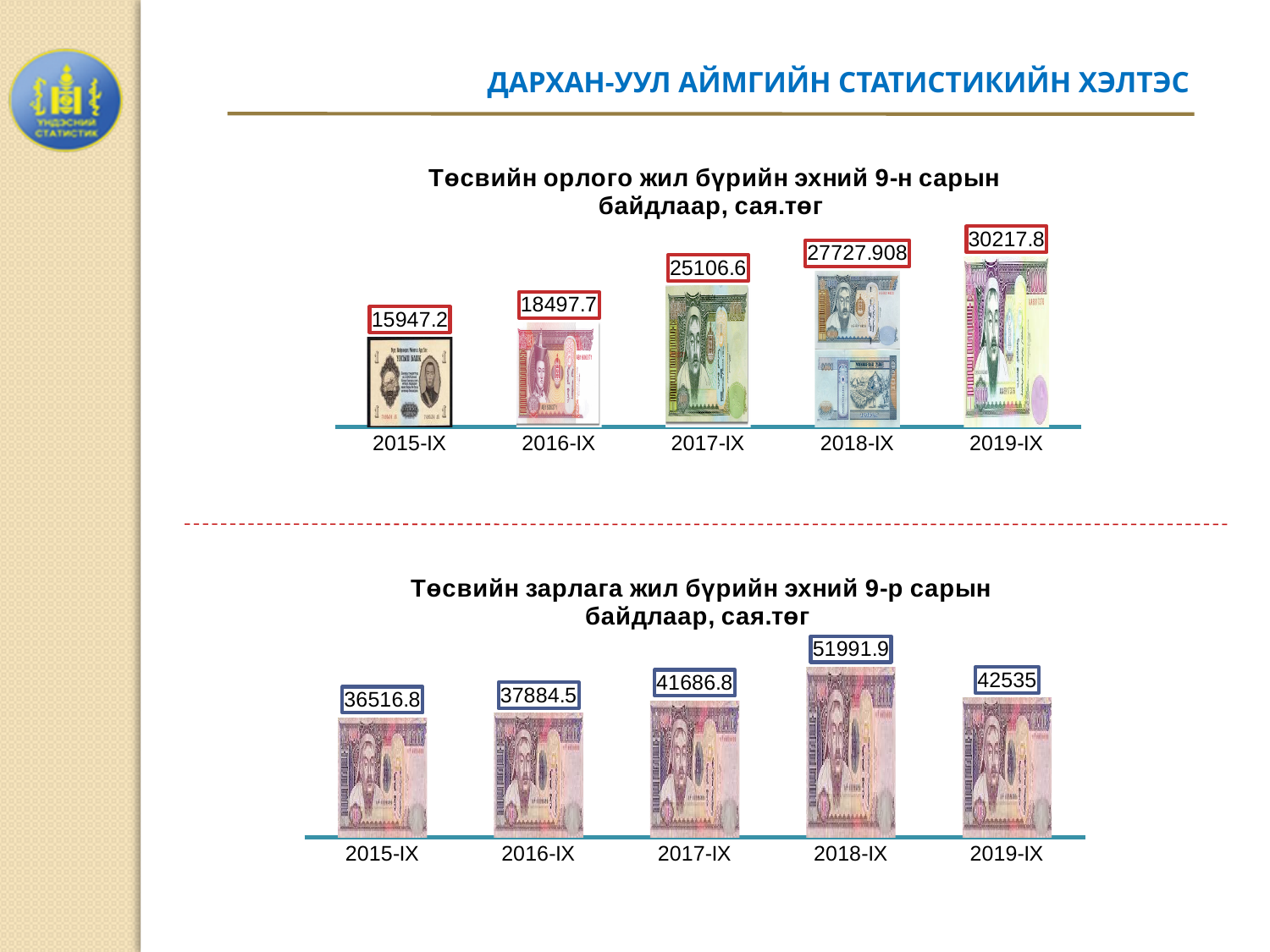
In the bottom chart (Төсвийн зарлага), how many years are shown on the x axis? 5 In the top chart (Төсвийн орлого), which year has the lowest value? 2015-IX In the top chart (Төсвийн орлого), what is the value for 2017-IX? 25106.6 What kind of chart is the top chart (Төсвийн орлого)? bar chart In the top chart (Төсвийн орлого), what is the difference between the 2019-IX and 2015-IX values? 14270.6 In the top chart (Төсвийн орлого), what is the value for 2018-IX? 27727.908 In the bottom chart (Төсвийн зарлага), which year has the highest value? 2018-IX In the top chart (Төсвийн орлого), do the values rise or fall from 2015-IX to 2019-IX? rise In the bottom chart (Төсвийн зарлага), what is the difference between the 2018-IX and 2019-IX values? 9456.9 In the bottom chart (Төсвийн зарлага), what is the value for 2016-IX? 37884.5 In the bottom chart (Төсвийн зарлага), what is the value for 2019-IX? 42535 In the top chart (Төсвийн орлого), which year has the highest value? 2019-IX